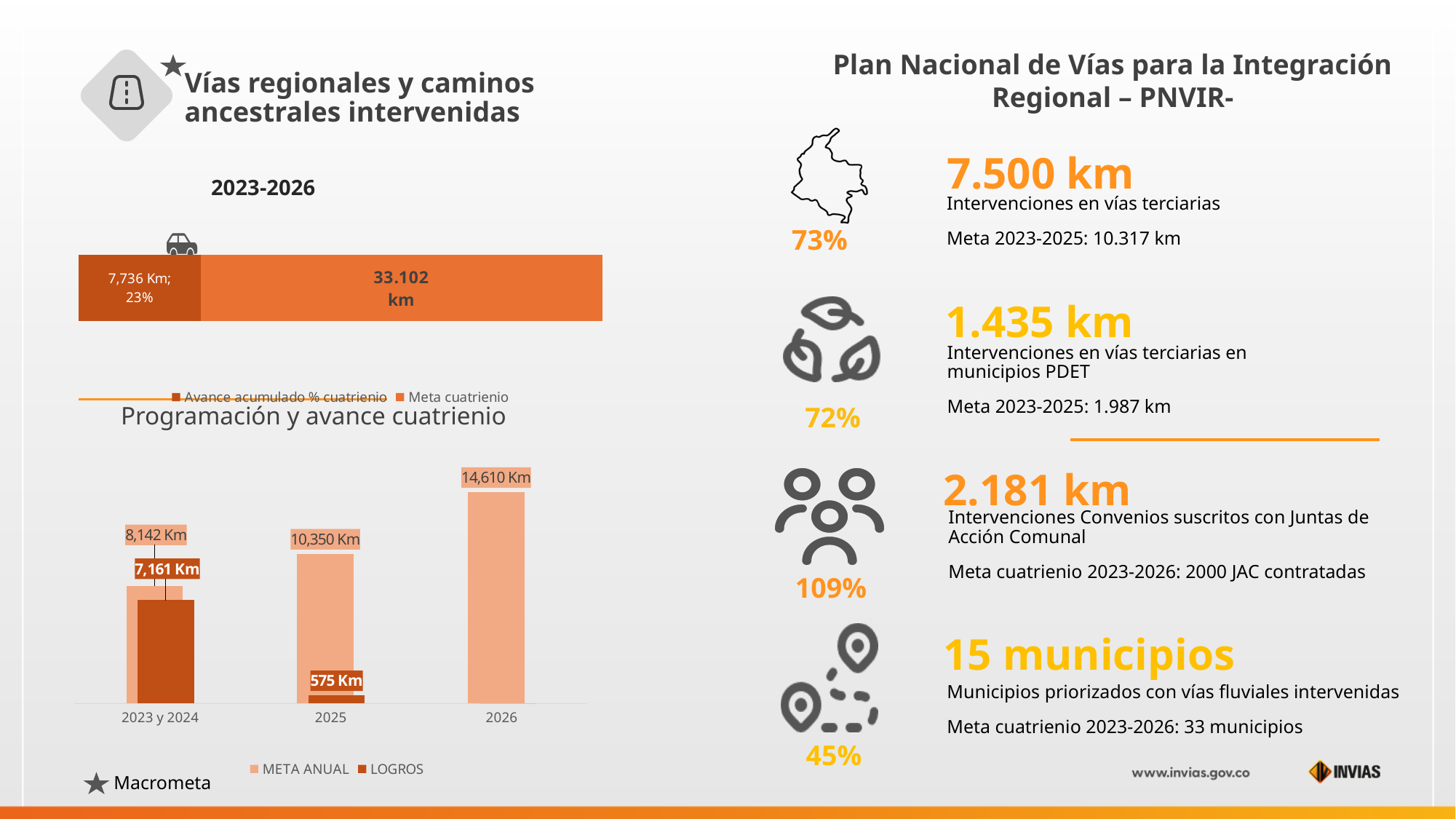
In the chart titled "Programación y avance cuatrienio", what is the LOGROS value for 2025? 575 Km In the chart titled "Programación y avance cuatrienio", which category has the highest META ANUAL value? 2026 In the chart titled "Programación y avance cuatrienio", what is the LOGROS value for 2023 y 2024? 7,161 Km In the chart titled "Programación y avance cuatrienio", do the META ANUAL values rise or fall from 2023 y 2024 to 2026? rise In the chart titled "Programación y avance cuatrienio", what is the difference between the META ANUAL and LOGROS values for 2023 y 2024? 981 Km In the chart titled "Programación y avance cuatrienio", which category has the lowest META ANUAL value? 2023 y 2024 In the chart titled "Programación y avance cuatrienio", is the LOGROS value for 2023 y 2024 larger or smaller than the LOGROS value for 2025? larger In the chart titled "Programación y avance cuatrienio", how many series does the legend list? 2 In the chart labelled "2023-2026" at the top left of the slide, what is the value of the Meta cuatrienio bar? 33.102 km What kind of chart is the chart labelled "2023-2026" at the top left of the slide? bar chart In the chart titled "Programación y avance cuatrienio", what is the META ANUAL value for 2026? 14,610 Km In the chart titled "Programación y avance cuatrienio", what is the difference between the META ANUAL values for 2026 and 2025? 4,260 Km